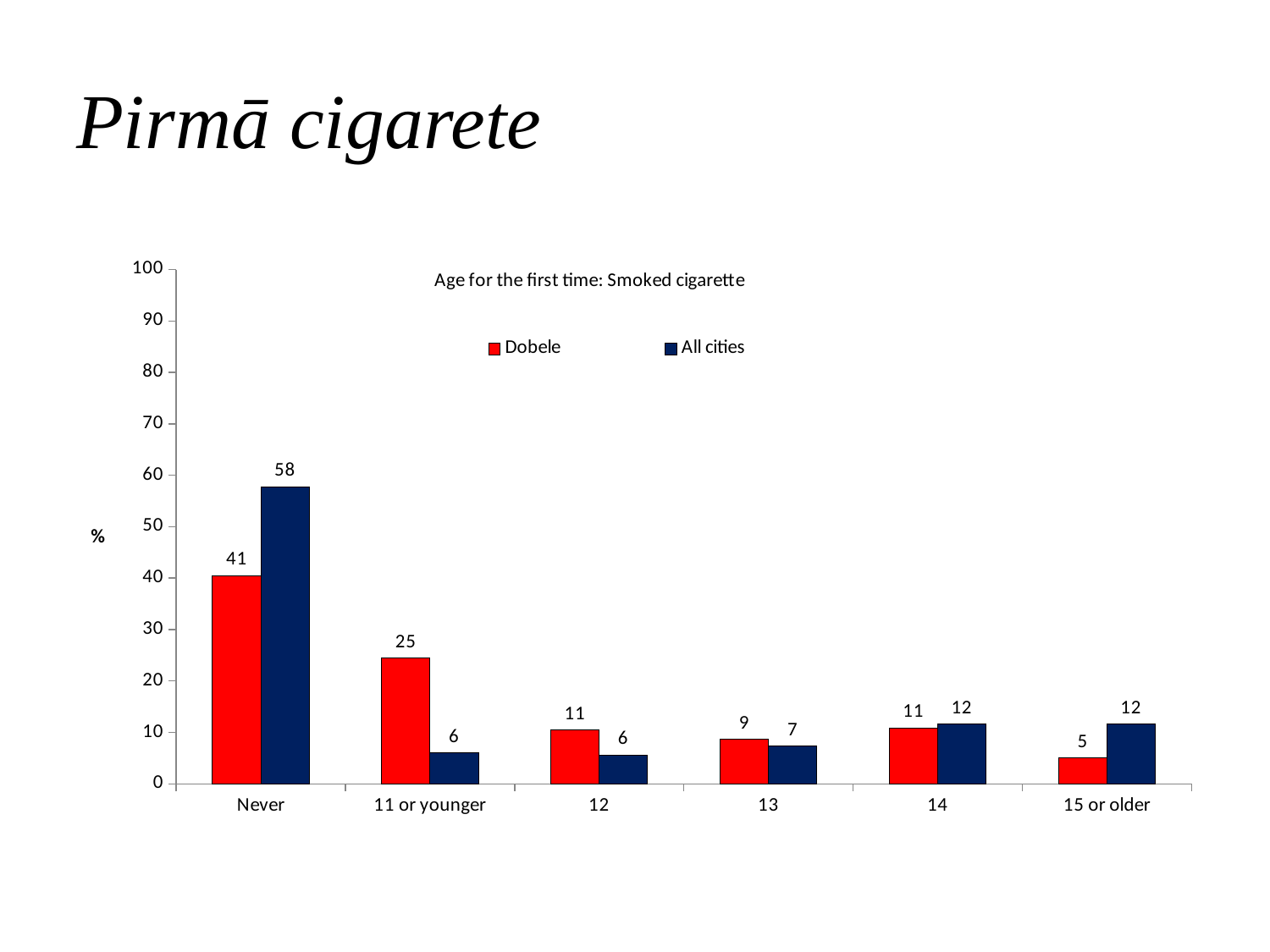
What is the difference between All cities and Dobele in the Never category? 17 How many series does the legend list? 2 Is the value for All cities in the Never category greater or less than 50? greater Which category has the lowest value for Dobele? 15 or older Which category has the highest value for Dobele? Never What is the value for All cities in the Never category? 58 What kind of chart is shown on the slide? bar chart Which is larger in the 11 or younger category, Dobele or All cities? Dobele How many categories are shown on the x axis? 6 What is the value for Dobele in the Never category? 41 What is the value for Dobele in the 11 or younger category? 25 What is the value for All cities in the 13 category? 7